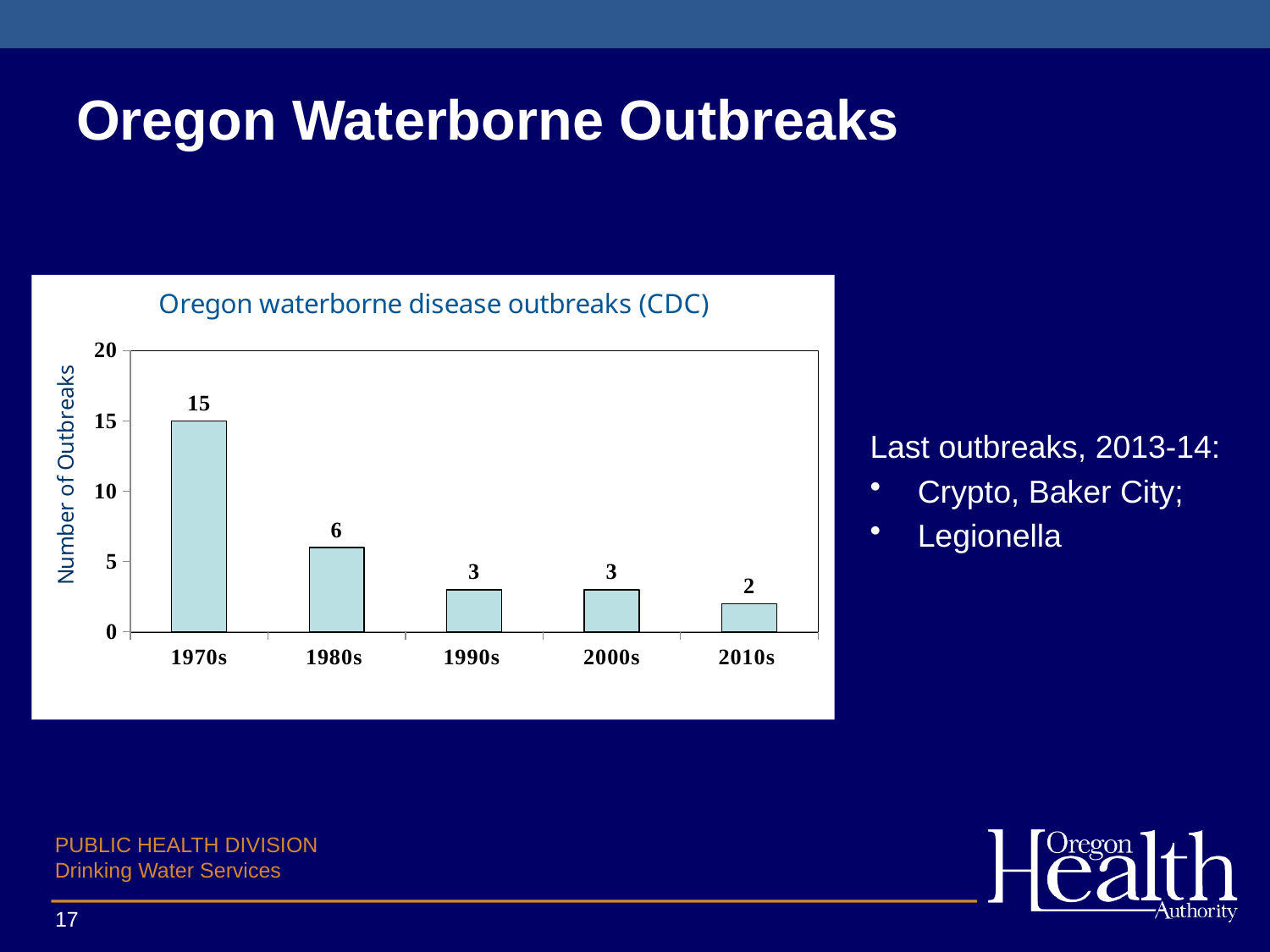
Which decade has the highest number of outbreaks? 1970s What is the number of outbreaks shown for the 2010s? 2 Which decade had more outbreaks, the 1980s or the 2000s? 1980s Is the value for the 1970s greater or less than 10? greater Which decade has the lowest number of outbreaks? 2010s How many decades are shown on the x axis of the chart? 5 What is the difference in the number of outbreaks between the 1970s and the 1980s? 9 How many waterborne disease outbreaks were recorded in Oregon in the 1970s? 15 Do the number of outbreaks generally rise or fall from the 1970s to the 2010s? Fall What is the title of the chart? Oregon waterborne disease outbreaks (CDC) What is the number of outbreaks shown for the 1980s? 6 What kind of chart is used to show the outbreak data? Bar chart